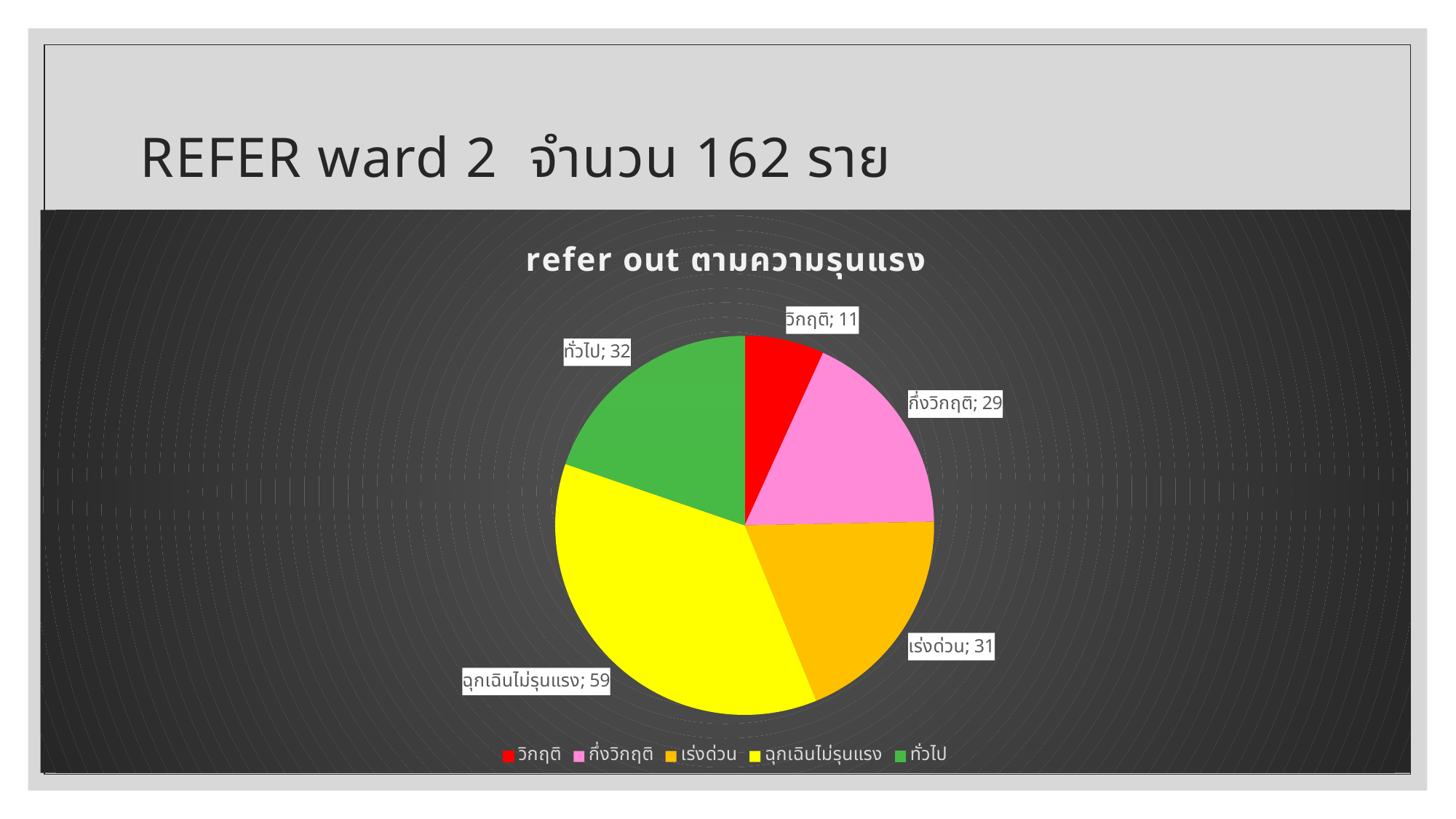
What is the value for วิกฤติ in the pie chart? 11 What type of chart is shown on the slide? pie chart What is the value for เร่งด่วน in the pie chart? 31 What is the difference between the values for ฉุกเฉินไม่รุนแรง and ทั่วไป? 27 Which category has the largest slice in the pie chart? ฉุกเฉินไม่รุนแรง What is the title of the chart? refer out ตามความรุนแรง What is the value for กึ่งวิกฤติ in the pie chart? 29 What colour is the slice for ฉุกเฉินไม่รุนแรง? yellow What is the value for ฉุกเฉินไม่รุนแรง in the pie chart? 59 Which is larger, the value for กึ่งวิกฤติ or the value for วิกฤติ? กึ่งวิกฤติ Which category has the smallest slice in the pie chart? วิกฤติ How many categories are shown in the pie chart? 5